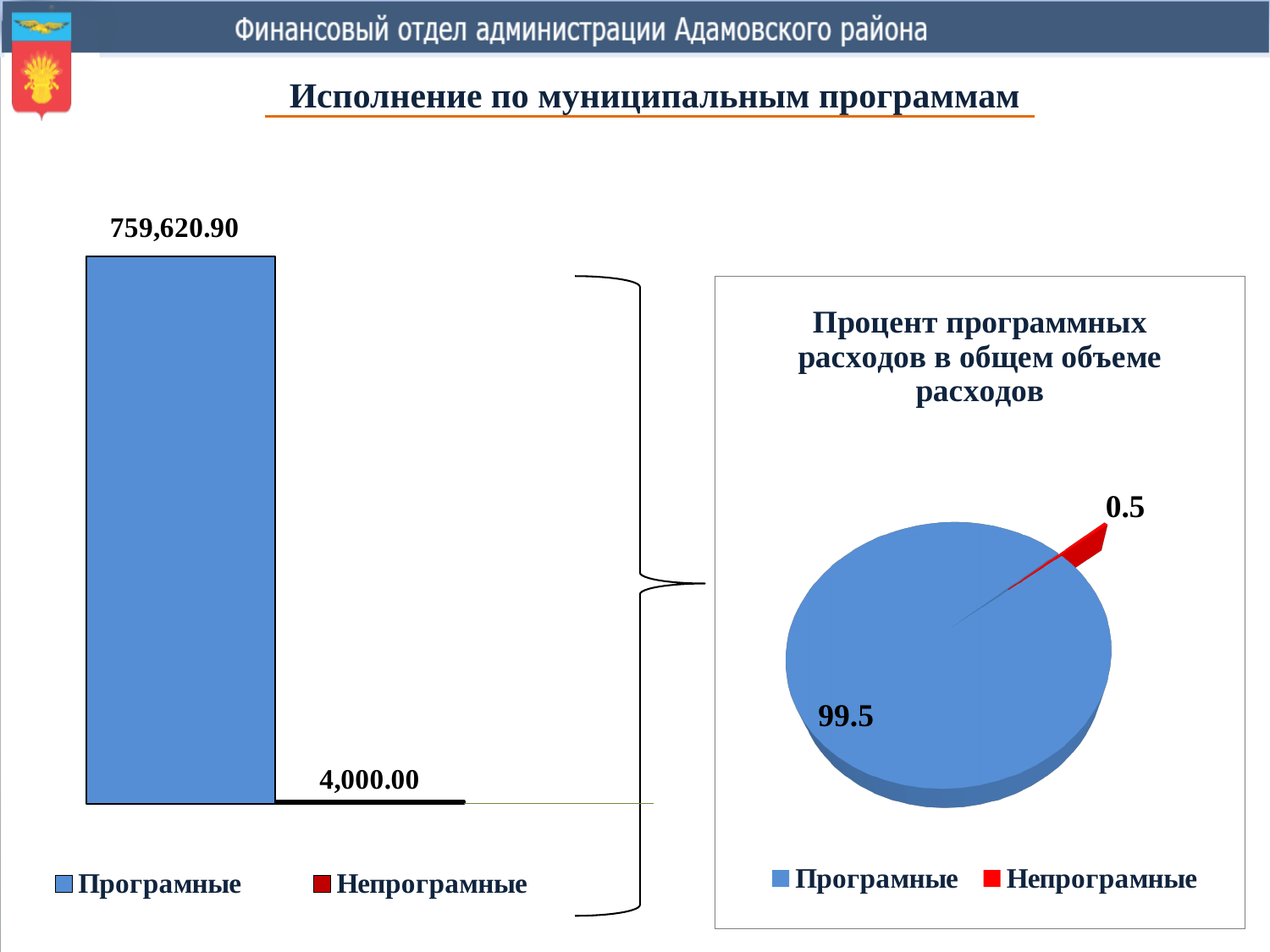
In the bar chart on the left, which category has the lowest value? Непрограмные In the chart titled 'Процент программных расходов в общем объеме расходов', what is the value for Непрограмные? 0.5 What kind of chart is shown on the right of the slide? Pie chart In the chart titled 'Процент программных расходов в общем объеме расходов', which slice is larger, Програмные or Непрограмные? Програмные In the bar chart on the left, how many series does the legend list? 2 In the pie chart on the right, what colour is the Непрограмные slice? Red In the bar chart on the left, what is the value for Непрограмные? 4,000.00 In the bar chart on the left, what is the difference between the values for Програмные and Непрограмные? 755,620.90 In the bar chart on the left, which category has the highest value? Програмные What kind of chart is shown on the left of the slide? Bar chart In the chart titled 'Процент программных расходов в общем объеме расходов', what is the value for Програмные? 99.5 In the bar chart on the left, what is the value for Програмные? 759,620.90